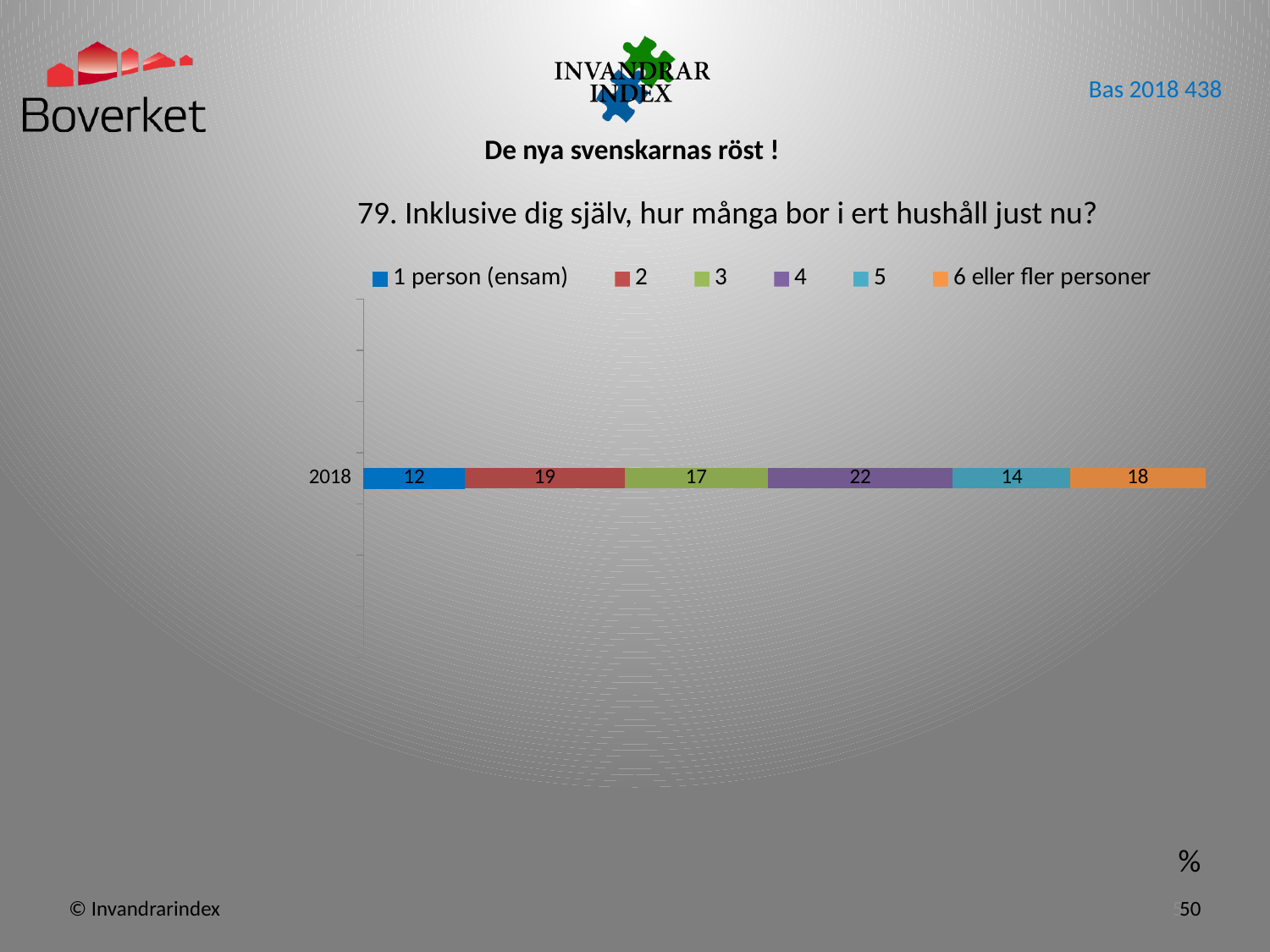
What is the value for '6 eller fler personer' in 2018? 18 What is the title of the chart? 79. Inklusive dig själv, hur många bor i ert hushåll just nu? How many series does the legend list? 6 Which is larger in 2018, the value for '3' or the value for '6 eller fler personer'? 6 eller fler personer Which series has the highest value in the 2018 bar? 4 Which series has the lowest value in the 2018 bar? 1 person (ensam) What is the value for '1 person (ensam)' in 2018? 12 What kind of chart is shown on the slide? Stacked bar chart How many categories (years) are shown on the chart's axis? 1 What is the value for the '4' series in the 2018 bar? 22 What is the difference between the values for '2' and '5' in 2018? 5